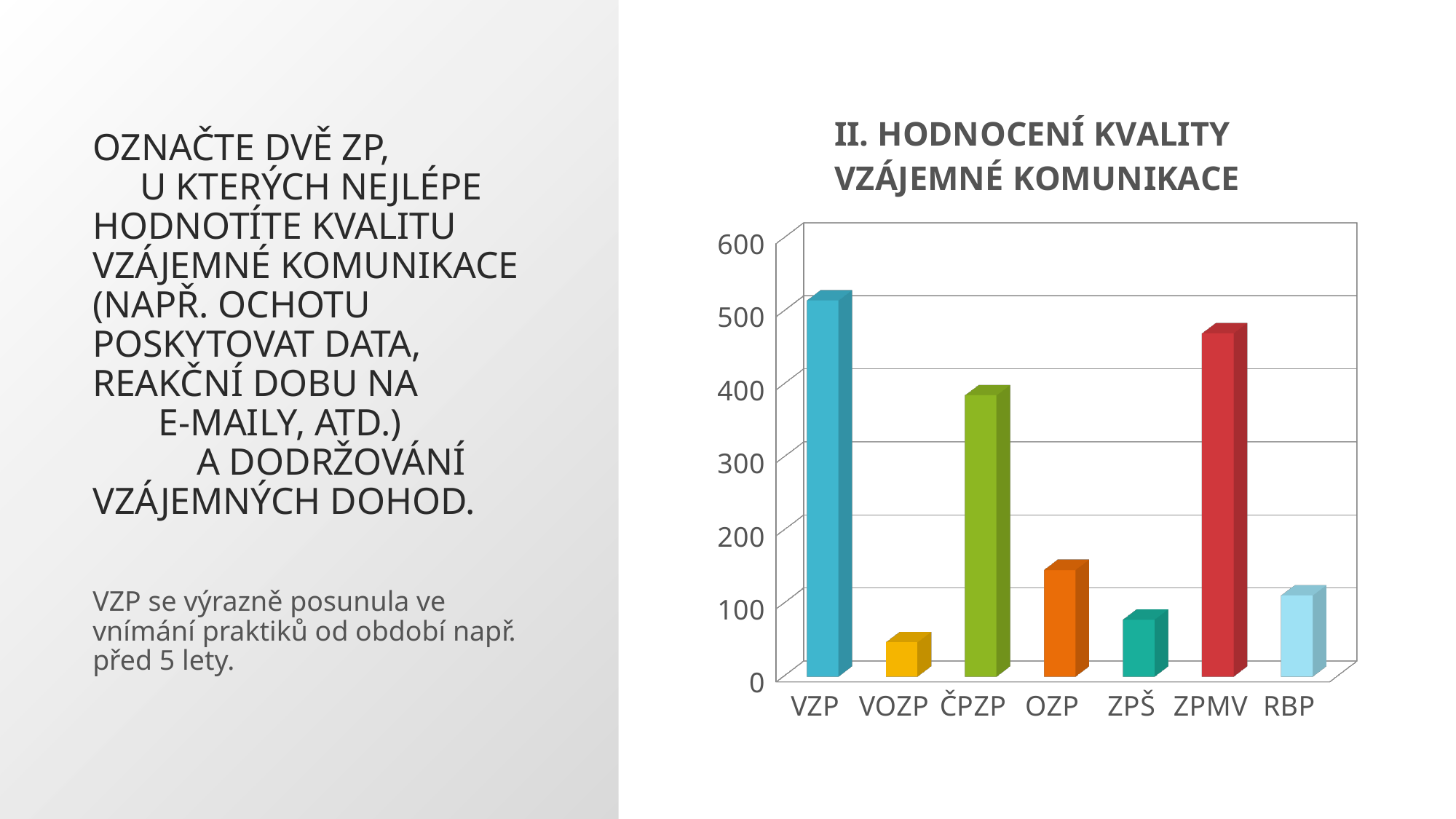
Is the value for VZP greater or less than 400? greater What type of chart is shown on the slide? Bar chart Is the value for VOZP greater or less than 100? less Is the value for ČPZP greater or less than 300? greater Which category has the highest value in the chart? VZP Which has a larger value, OZP or RBP? OZP What is the title of the chart? II. HODNOCENÍ KVALITY VZÁJEMNÉ KOMUNIKACE How many categories (insurance companies) are shown on the x axis of the chart? 7 Which has a larger value, ZPMV or ČPZP? ZPMV Which category has the lowest value in the chart? VOZP Which has a larger value, ZPŠ or VOZP? ZPŠ